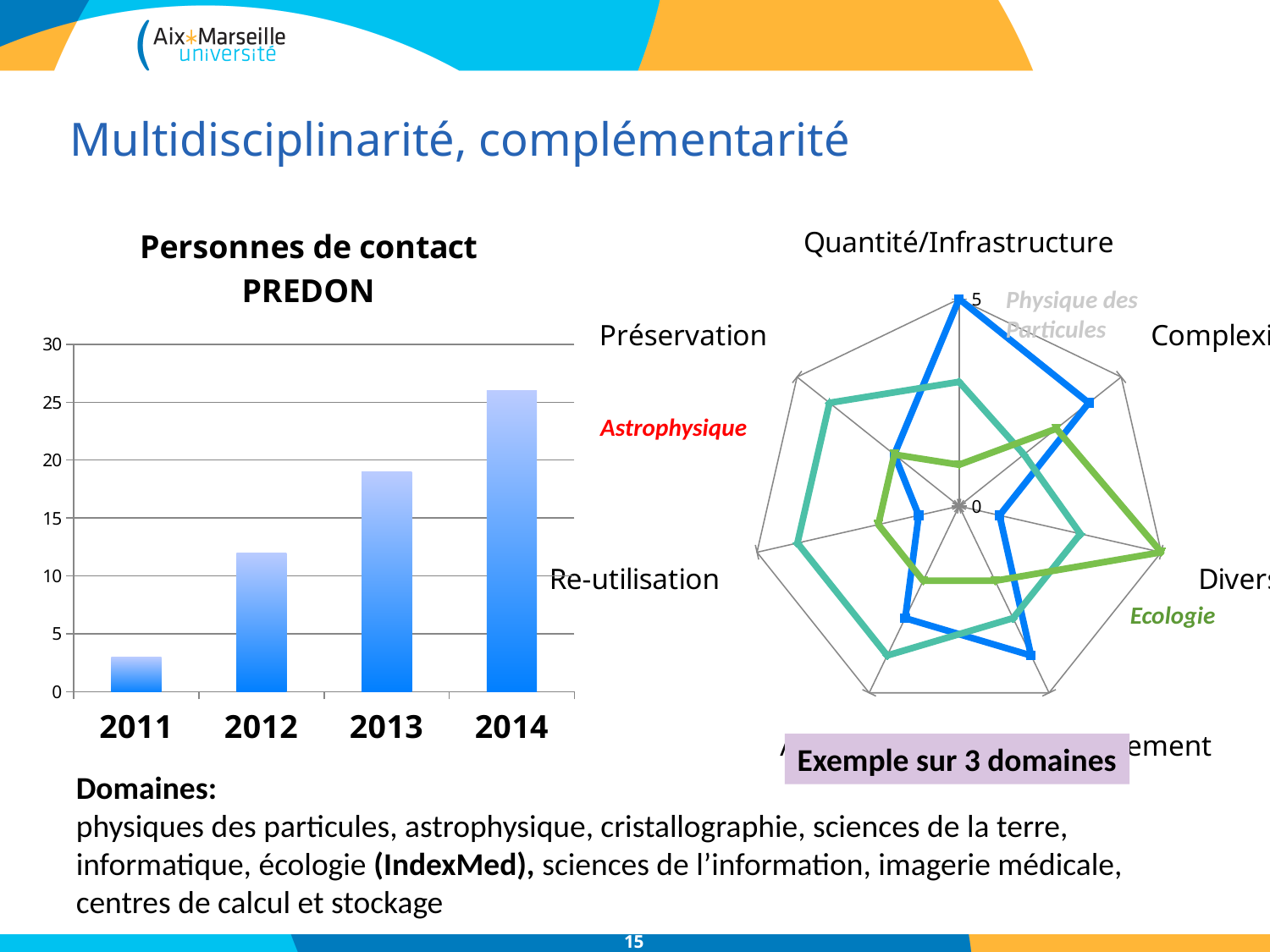
In the 'Personnes de contact PREDON' chart, which year has the larger value, 2012 or 2013? 2013 What is the title of the bar chart on the left of the slide? Personnes de contact PREDON What kind of chart is the chart on the right of the slide with the axes Quantité/Infrastructure, Préservation and Re-utilisation? radar chart In the 'Personnes de contact PREDON' chart, is the value for 2011 greater or less than 5? less In the 'Personnes de contact PREDON' chart, is the value for 2014 greater or less than 20? greater In the 'Personnes de contact PREDON' chart, which year has the highest value? 2014 What kind of chart is the 'Personnes de contact PREDON' chart on the left? bar chart In the 'Personnes de contact PREDON' chart, is the value for 2013 greater or less than 15? greater In the 'Personnes de contact PREDON' chart, which year has the lowest value? 2011 In the 'Personnes de contact PREDON' chart, do the values rise or fall from 2011 to 2014? rise In the 'Personnes de contact PREDON' chart, how many years are shown on the x axis? 4